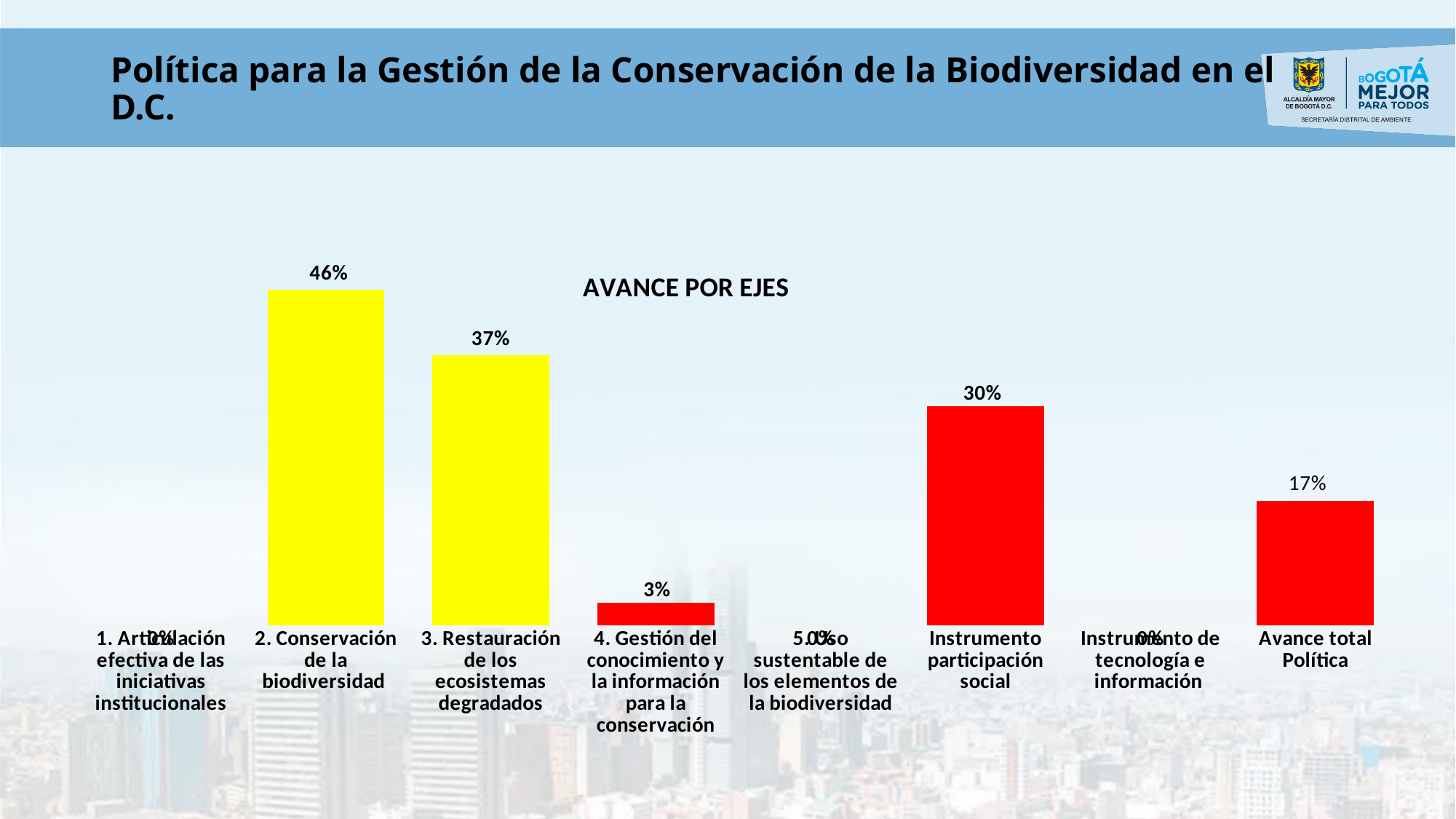
How many categories are shown on the x axis of the chart? 8 What is the title of the chart? AVANCE POR EJES Which category has the highest value? 2. Conservación de la biodiversidad What colour are the bars for "2. Conservación de la biodiversidad" and "3. Restauración de los ecosistemas degradados"? yellow What is the value for "4. Gestión del conocimiento y la información para la conservación"? 3% What type of chart is shown on the slide? bar chart What is the value for "Instrumento participación social"? 30% What is the value for "2. Conservación de la biodiversidad"? 46% What is the difference between the values for "2. Conservación de la biodiversidad" and "3. Restauración de los ecosistemas degradados"? 9% Which is larger, the value for "Instrumento participación social" or the value for "Avance total Política"? Instrumento participación social What is the value for "Avance total Política"? 17% What is the value for "3. Restauración de los ecosistemas degradados"? 37%